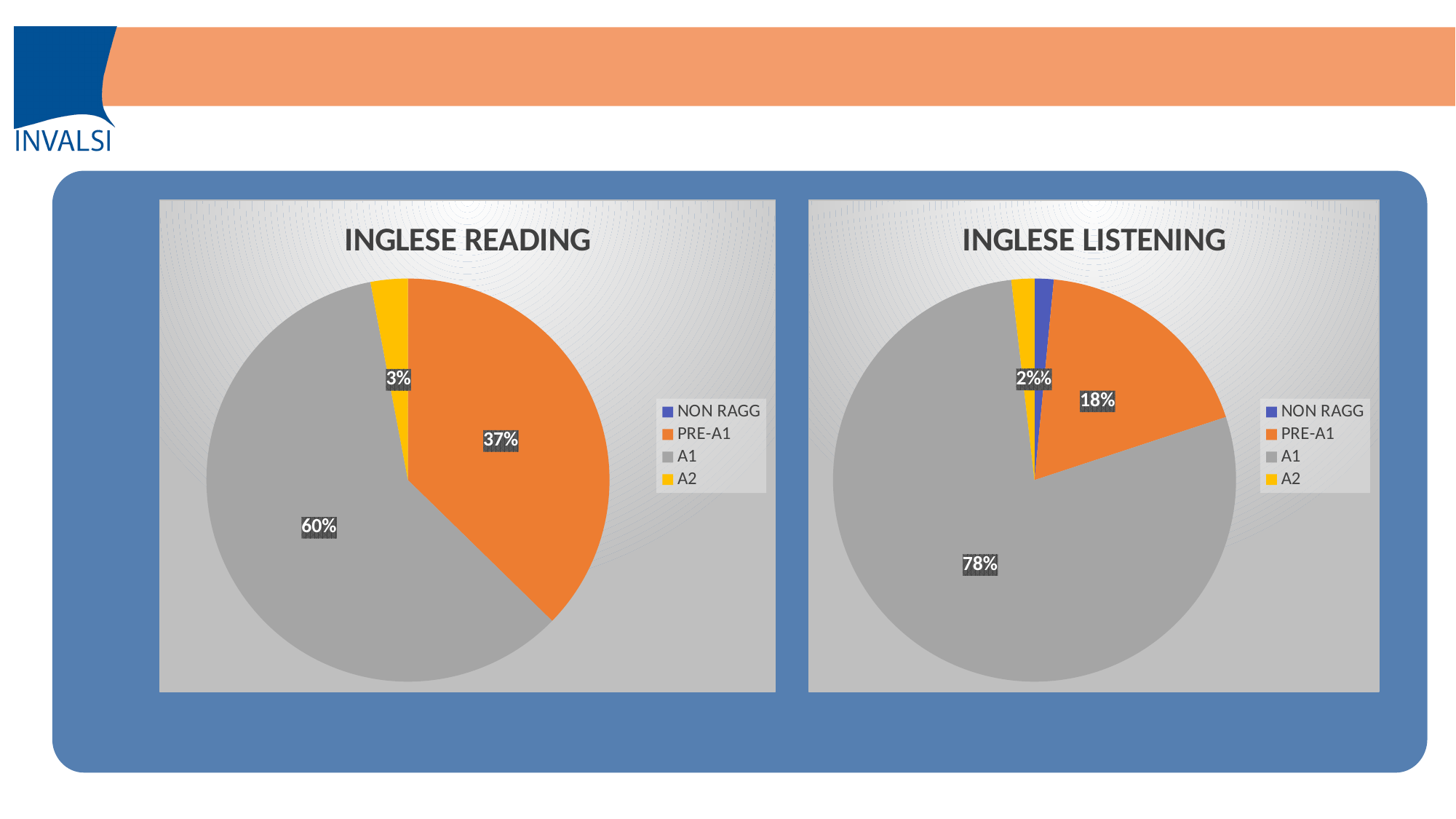
In the INGLESE LISTENING chart, how many percentage points larger is A1 than PRE-A1? 60% In the INGLESE LISTENING chart, what percentage is shown for PRE-A1? 18% In the INGLESE READING chart, what percentage is shown for A2? 3% Is the A1 share larger in the INGLESE READING chart or in the INGLESE LISTENING chart? INGLESE LISTENING In the INGLESE LISTENING chart, what percentage is shown for A1? 78% In the INGLESE READING chart, what percentage is shown for A1? 60% What kind of chart is INGLESE READING? Pie chart How many entries does the legend of the INGLESE LISTENING chart list? 4 In the INGLESE READING chart, which category has the largest slice? A1 In the INGLESE READING chart, how many percentage points larger is A1 than PRE-A1? 23% In the INGLESE READING chart, what percentage is shown for PRE-A1? 37% In the INGLESE LISTENING chart, which category has the largest slice? A1